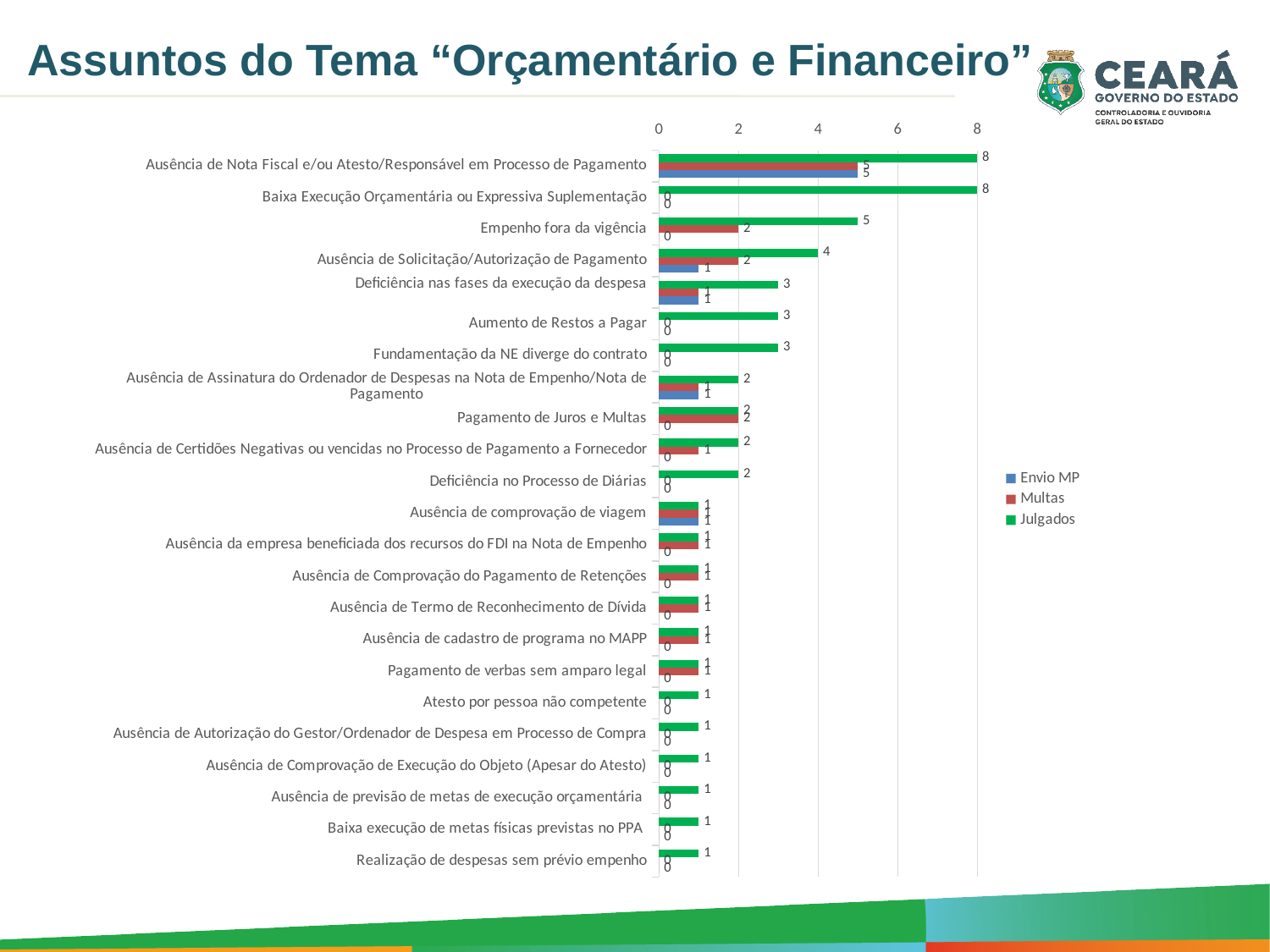
What kind of chart is shown on the slide? Bar chart What is the Multas value for "Ausência de Nota Fiscal e/ou Atesto/Responsável em Processo de Pagamento"? 5 How many categories are plotted on the chart? 23 What is the Julgados value for "Ausência de Solicitação/Autorização de Pagamento"? 4 How many series does the legend list? 3 What is the difference between the Julgados and Multas values for "Ausência de Nota Fiscal e/ou Atesto/Responsável em Processo de Pagamento"? 3 What is the Julgados value for "Aumento de Restos a Pagar"? 3 What is the Julgados value for "Empenho fora da vigência"? 5 What is the Multas value for "Pagamento de Juros e Multas"? 2 Which series is shown in green in the legend? Julgados Which has a higher Julgados value: "Empenho fora da vigência" or "Deficiência nas fases da execução da despesa"? Empenho fora da vigência What is the difference between the Julgados and Multas values for "Empenho fora da vigência"? 3